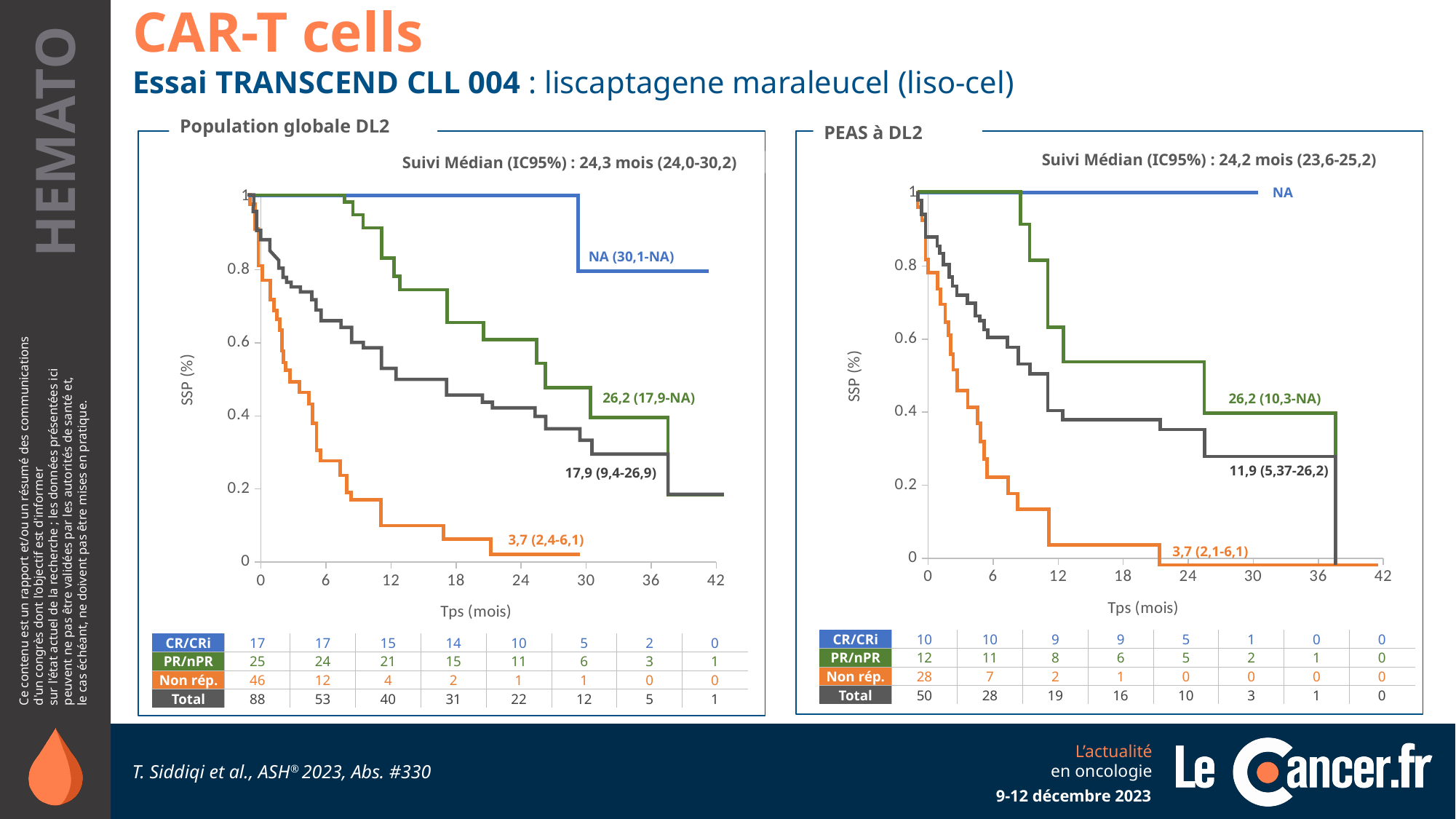
What kind of chart is shown in the 'Population globale DL2' panel? line chart How many curves (groups) are plotted in the 'Population globale DL2' chart? 4 In the 'PEAS à DL2' chart, how many CR/CRi patients are at risk at 0 months according to the table? 10 In the 'Population globale DL2' chart, is the blue CR/CRi curve at 24 months greater or less than 0.8? greater In the 'Population globale DL2' table, which group has more patients at risk at 6 months: PR/nPR or Non rép.? PR/nPR In the 'Population globale DL2' chart, what median value is printed next to the green PR/nPR curve? 26,2 (17,9-NA) In the 'Population globale DL2' chart, how many Total patients are at risk at 12 months? 40 In the 'PEAS à DL2' chart, is the orange Non rép. curve at 12 months greater or less than 0.2? less In the 'PEAS à DL2' chart, what median value is printed next to the orange Non rép. curve? 3,7 (2,1-6,1) In the 'Population globale DL2' table, what is the difference between the Total at risk at 0 months and at 6 months? 35 In the 'PEAS à DL2' chart, what median value is printed next to the grey Total curve? 11,9 (5,37-26,2) What is the median follow-up (Suivi Médian) stated for the 'Population globale DL2' chart? 24,3 mois (24,0-30,2)